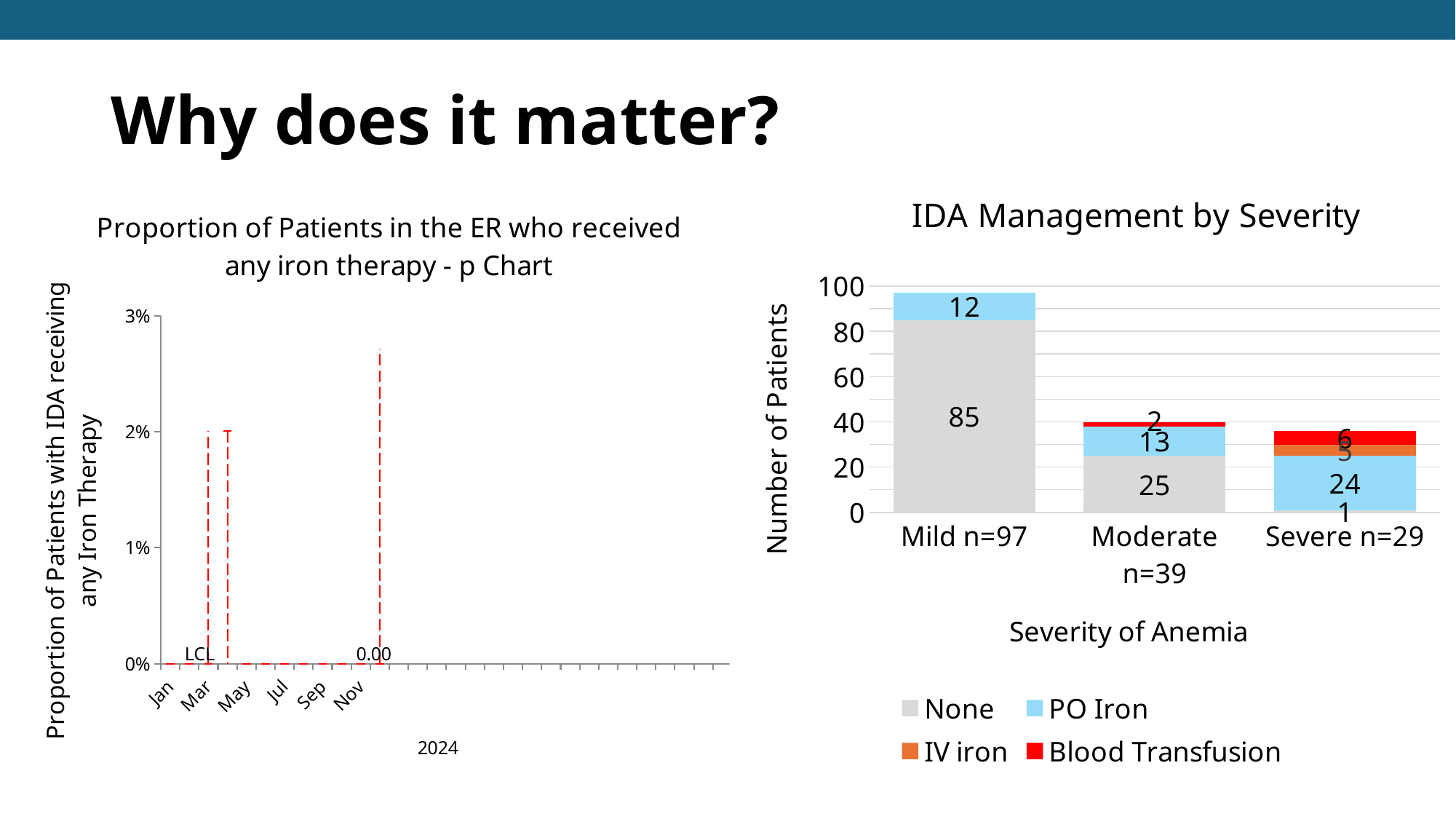
In the 'IDA Management by Severity' chart, how many patients with mild anemia received PO Iron? 12 How many severity categories are shown on the x axis of the 'IDA Management by Severity' chart? 3 In the 'IDA Management by Severity' chart, what is the None value for the Moderate n=39 group? 25 In the 'IDA Management by Severity' chart, what is the difference between the None values for the Mild and Moderate groups? 60 In the 'IDA Management by Severity' chart, which severity group has the highest None value? Mild n=97 In the 'IDA Management by Severity' chart, how many patients with mild anemia received no treatment (None)? 85 How many series does the legend of the 'IDA Management by Severity' chart list? 4 In the 'IDA Management by Severity' chart, how many patients in the Severe n=29 group received PO Iron? 24 What kind of chart is the 'IDA Management by Severity' chart? stacked bar chart In the 'IDA Management by Severity' chart, how many patients in the Severe n=29 group received a Blood Transfusion? 6 In the 'IDA Management by Severity' chart, which group has more PO Iron patients, Mild n=97 or Severe n=29? Severe n=29 What kind of chart is the 'Proportion of Patients in the ER who received any iron therapy - p Chart' on the left? line chart